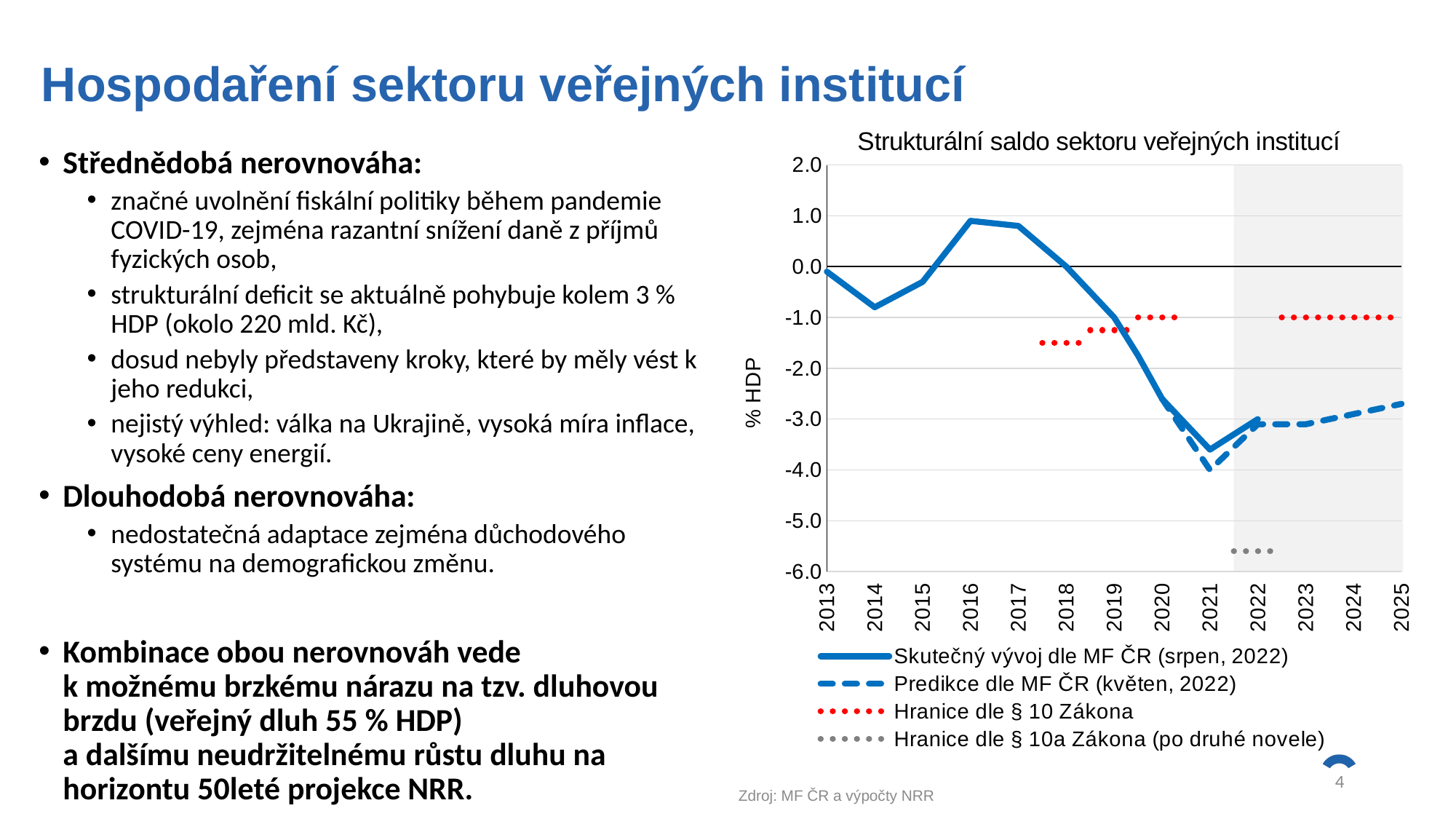
What is the label of the y axis? % HDP In which year does the 'Skutečný vývoj dle MF ČR (srpen, 2022)' line reach its highest value? 2016 Is the value of 'Skutečný vývoj dle MF ČR (srpen, 2022)' in 2021 greater or less than -3.0? less What kind of chart is shown on the slide? line chart How many years are shown on the x axis of the chart? 13 How many series does the chart legend list? 4 Does the 'Skutečný vývoj dle MF ČR (srpen, 2022)' line rise or fall between 2017 and 2021? fall Which year has the higher value on the 'Skutečný vývoj dle MF ČR (srpen, 2022)' line, 2020 or 2021? 2020 Is the value of 'Skutečný vývoj dle MF ČR (srpen, 2022)' in 2016 greater or less than 0.0? greater In which year does the 'Skutečný vývoj dle MF ČR (srpen, 2022)' line reach its lowest value? 2021 What is the title of the chart? Strukturální saldo sektoru veřejných institucí Is the value of 'Predikce dle MF ČR (květen, 2022)' in 2025 greater or less than -3.0? greater